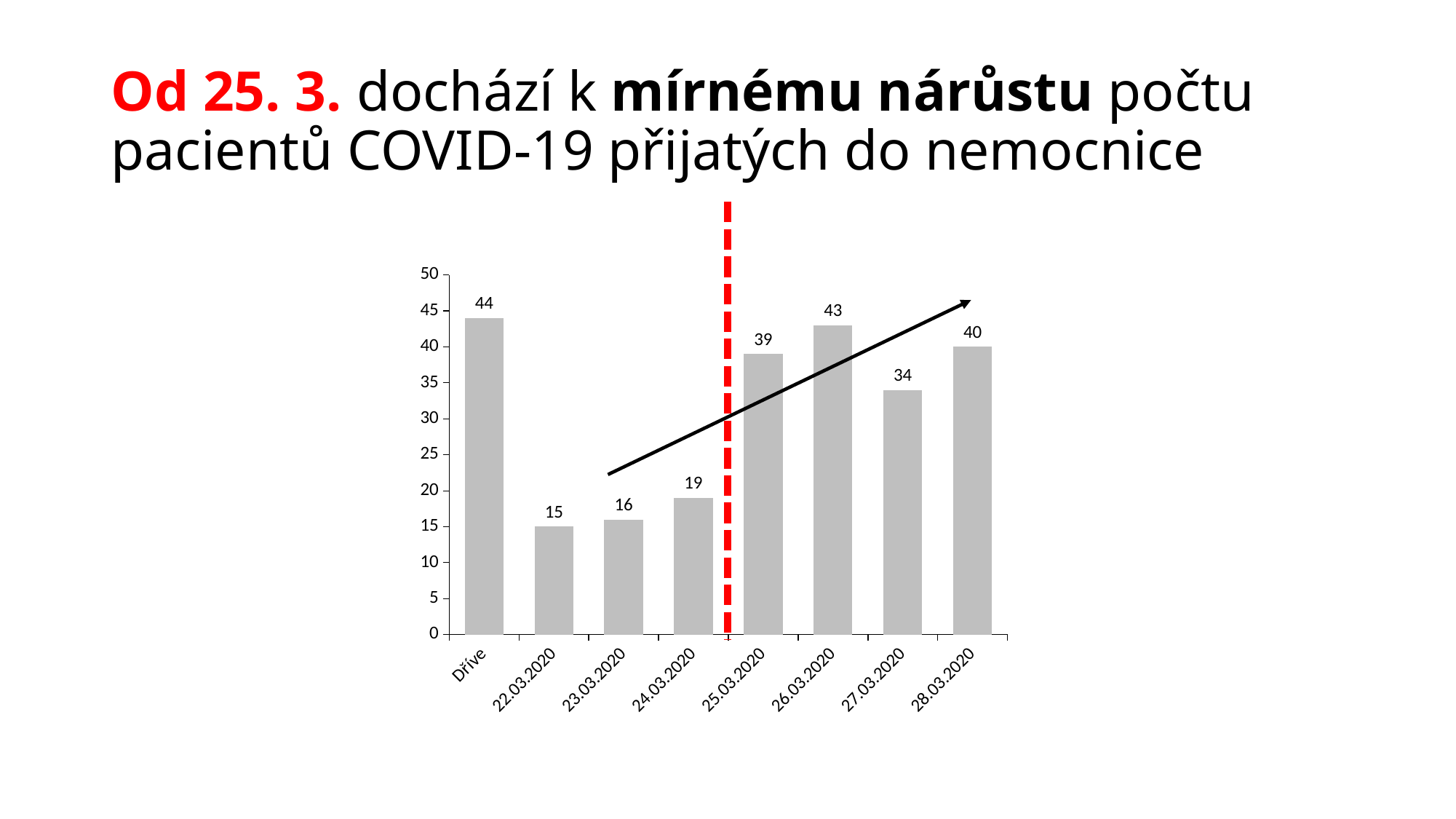
What is the value for Dříve? 44 What is the value for 24.03.2020? 19 Which category has the highest value? Dříve What is the value for 27.03.2020? 34 Which is larger, the value for 28.03.2020 or the value for 27.03.2020? 28.03.2020 How many categories are shown on the x axis? 8 What is the difference between the values for 26.03.2020 and 24.03.2020? 24 Do the values rise or fall from 22.03.2020 to 26.03.2020? rise Is the value for 23.03.2020 greater or less than 20? less What kind of chart is shown on the slide? bar chart What is the value for 25.03.2020? 39 Which category has the lowest value? 22.03.2020